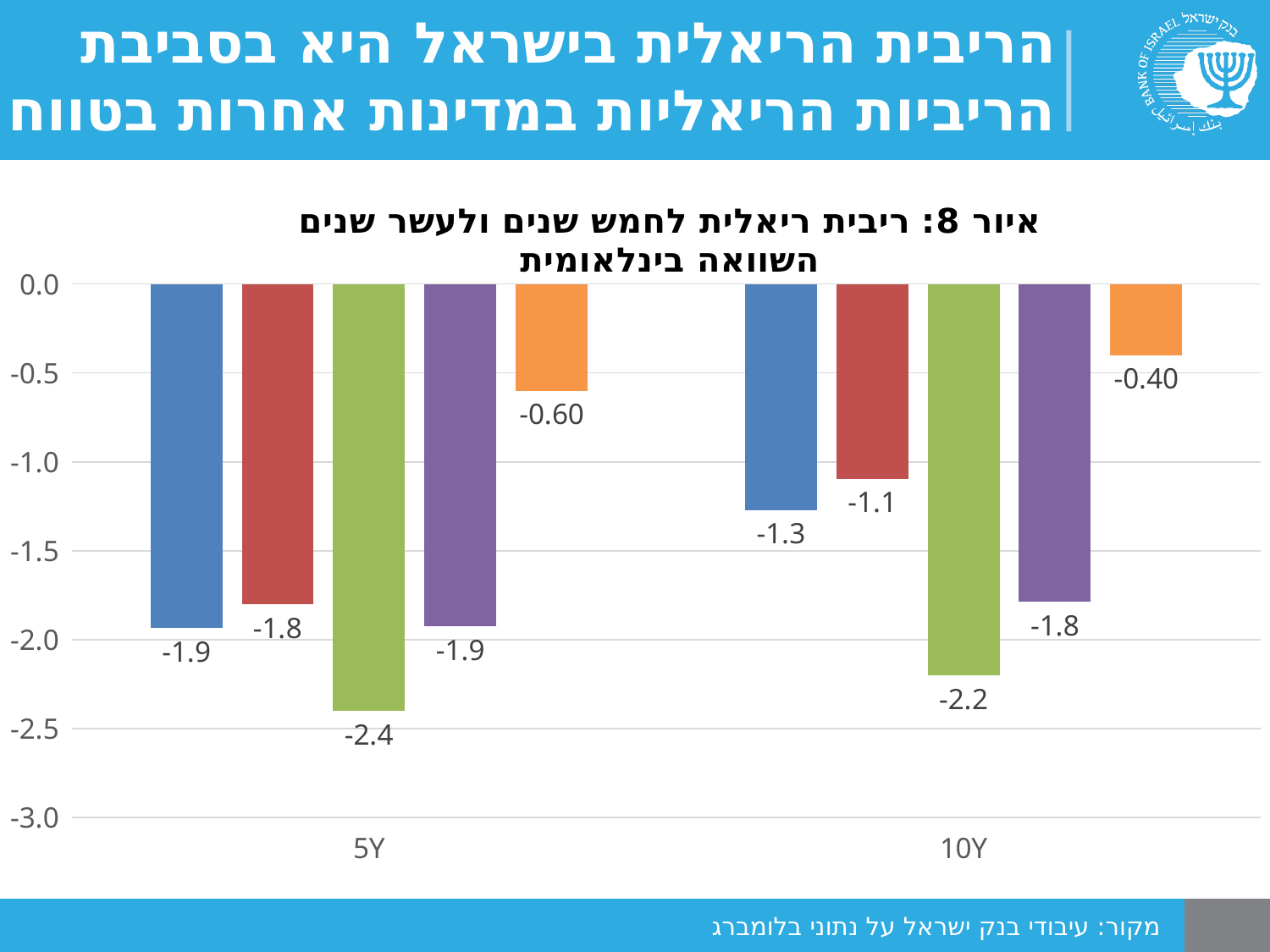
How many bars are in each category group? 5 What is the value of the red bar in the 5Y group? -1.8 What is the value of the orange bar in the 10Y group? -0.40 How many category groups are shown on the x axis? 2 Which bar in the 5Y group has the lowest value? The green bar (-2.4) Which bar in the 10Y group has the highest value? The orange bar (-0.40) What is the title of the chart? איור 8: ריבית ריאלית לחמש שנים ולעשר שנים השוואה בינלאומית What is the value of the green bar in the 5Y group? -2.4 Which is larger, the red bar in the 10Y group or the red bar in the 5Y group? The red bar in the 10Y group (-1.1) What is the difference between the green bar's value in the 5Y group and in the 10Y group? 0.2 What kind of chart is shown on the slide? Bar chart What is the value of the blue bar in the 10Y group? -1.3